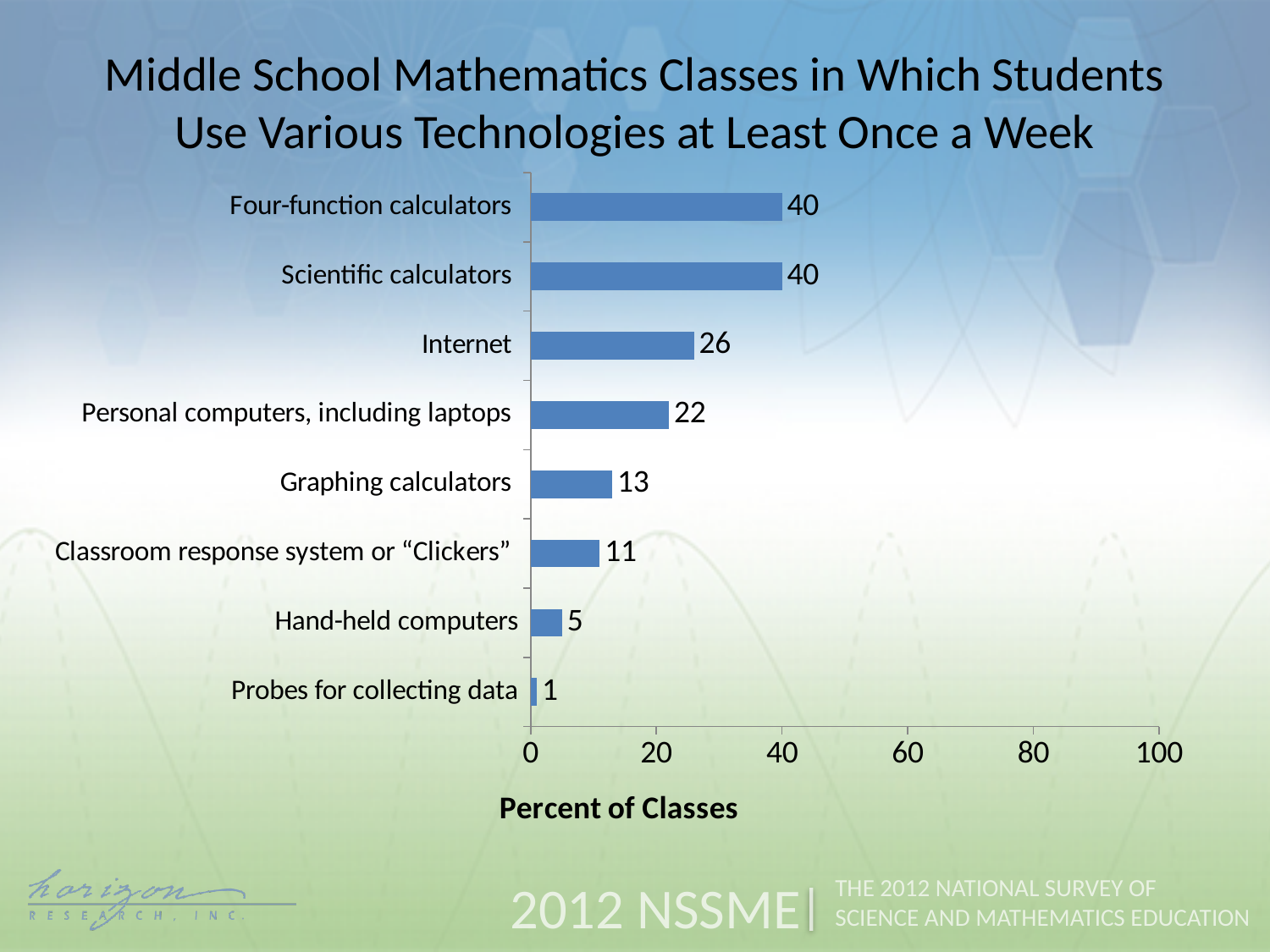
What is the difference between the values for Four-function calculators and Graphing calculators? 27 How many technology categories are shown in the chart? 8 What is the value for Graphing calculators? 13 What is the highest value shown on the horizontal axis? 100 What percent of classes use the Internet at least once a week? 26 Which is larger, the value for Classroom response system or "Clickers" or the value for Hand-held computers? Classroom response system or "Clickers" What is the label of the horizontal axis? Percent of Classes Which technology has the lowest percent of classes? Probes for collecting data What is the value for Hand-held computers? 5 What is the difference between the values for Internet and Personal computers, including laptops? 4 What kind of chart is shown on the slide? bar chart Is the value for Scientific calculators greater or less than 20? greater